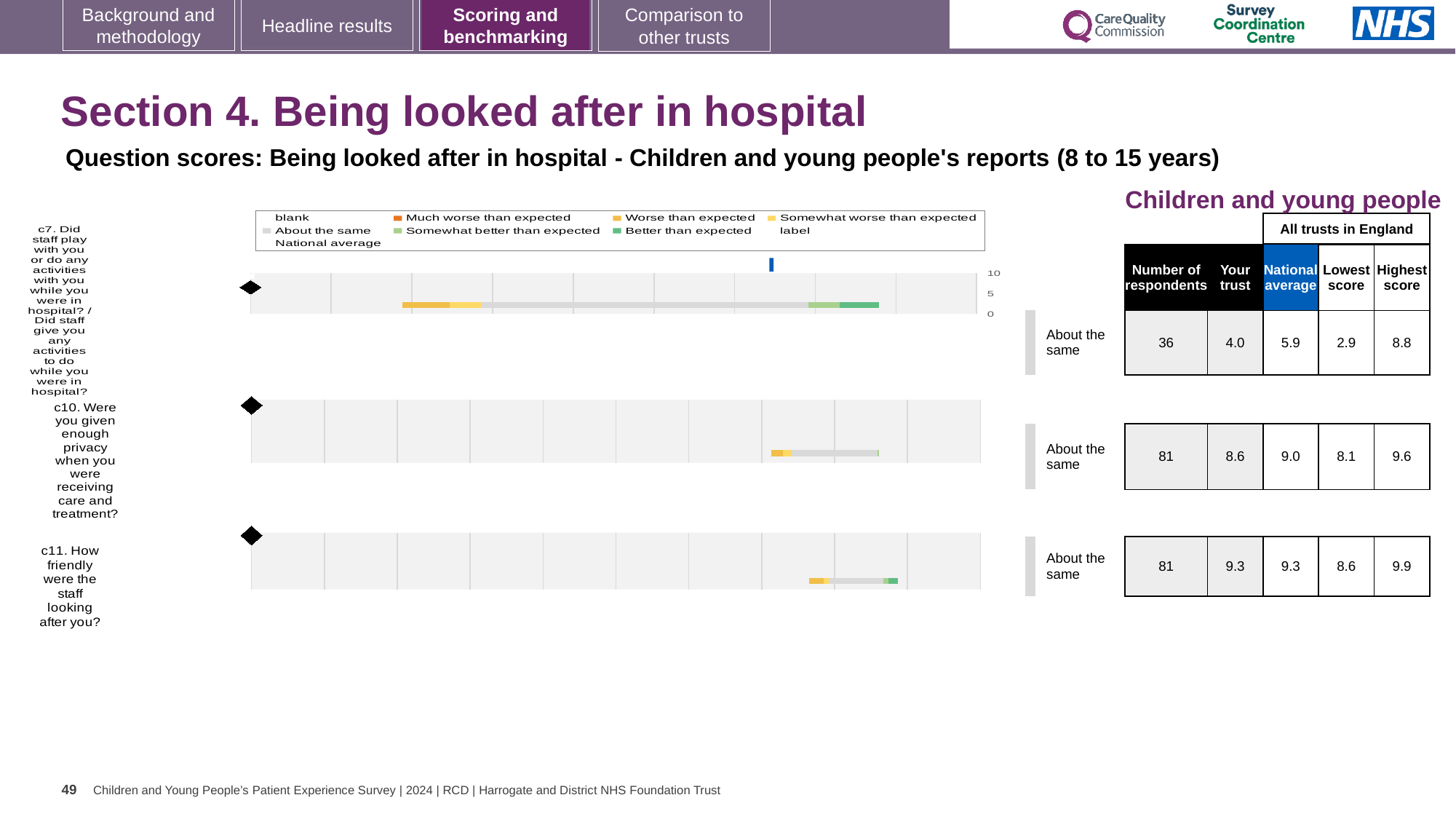
How many respondents answered c7 (Did staff play with you or do any activities with you while you were in hospital?)? 36 Which question has the lowest 'Your trust' score? c7. Did staff play with you or do any activities with you while you were in hospital? What is the 'Your trust' score for c11 (How friendly were the staff looking after you?)? 9.3 What is the national average score for c10 (Were you given enough privacy when you were receiving care and treatment?)? 9.0 What benchmark category is shown for c7? About the same Which question has the highest 'Your trust' score? c11. How friendly were the staff looking after you? How many questions (bars) are plotted in the chart? 3 What kind of chart is used to show the question scores on this slide? bar chart What is the difference between the highest and lowest scores for c7? 5.9 For c10, which is larger: the 'Your trust' score or the national average? National average What is the highest score among all trusts in England for c10? 9.6 For c7, how much higher is the national average than the 'Your trust' score? 1.9